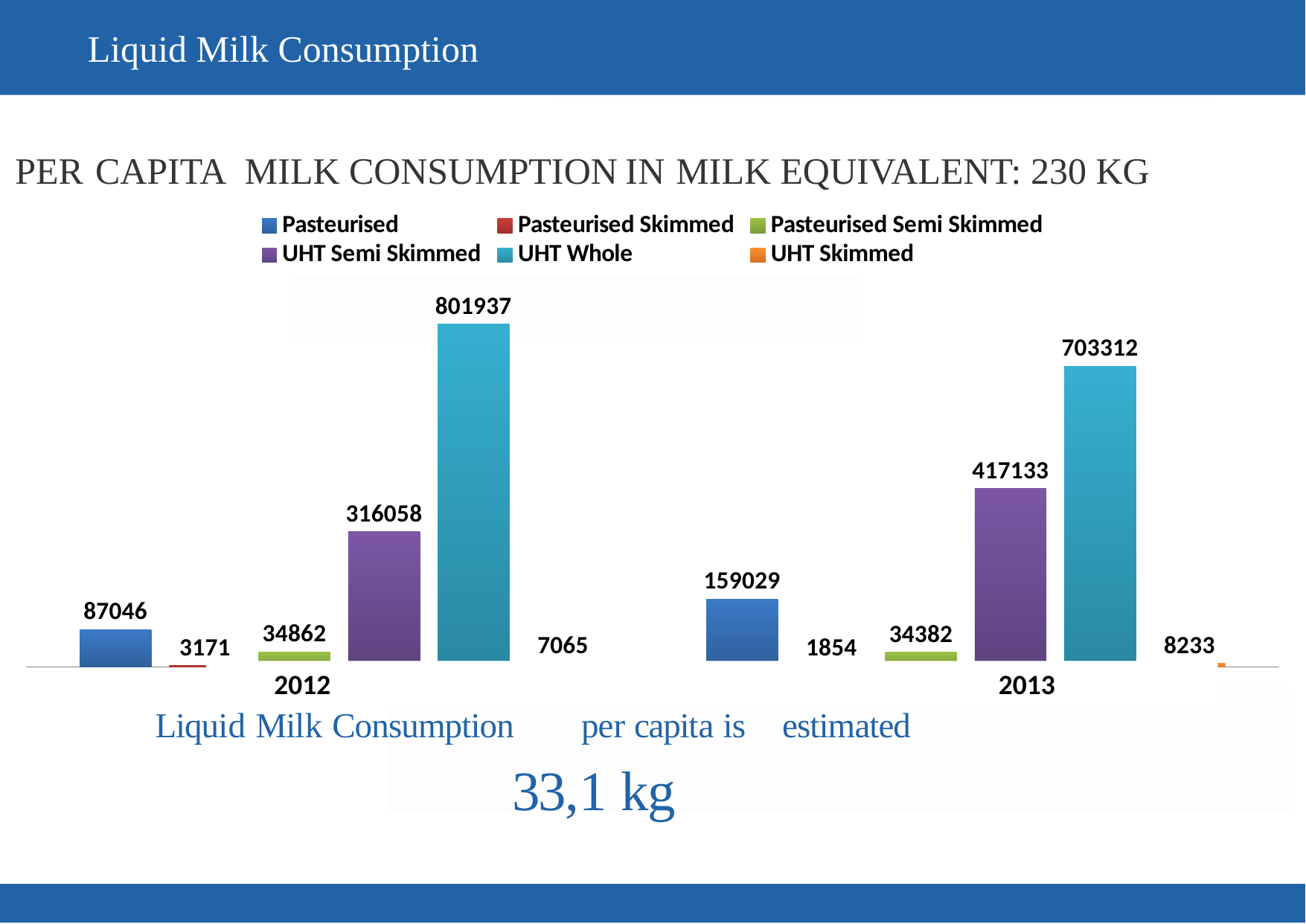
What kind of chart is shown? bar chart What is the value for UHT Semi Skimmed in 2013? 417133 What is the value for Pasteurised in 2013? 159029 Which series has the highest value in 2013? UHT Whole How many years are shown on the x axis? 2 What is the difference between the UHT Whole values for 2012 and 2013? 98625 Which is larger, the Pasteurised value in 2012 or in 2013? 2013 Which series has the lowest value in 2013? Pasteurised Skimmed What is the value for UHT Whole in 2012? 801937 Did the UHT Semi Skimmed value rise or fall from 2012 to 2013? rise How many series does the legend list? 6 What is the value for Pasteurised Skimmed in 2012? 3171